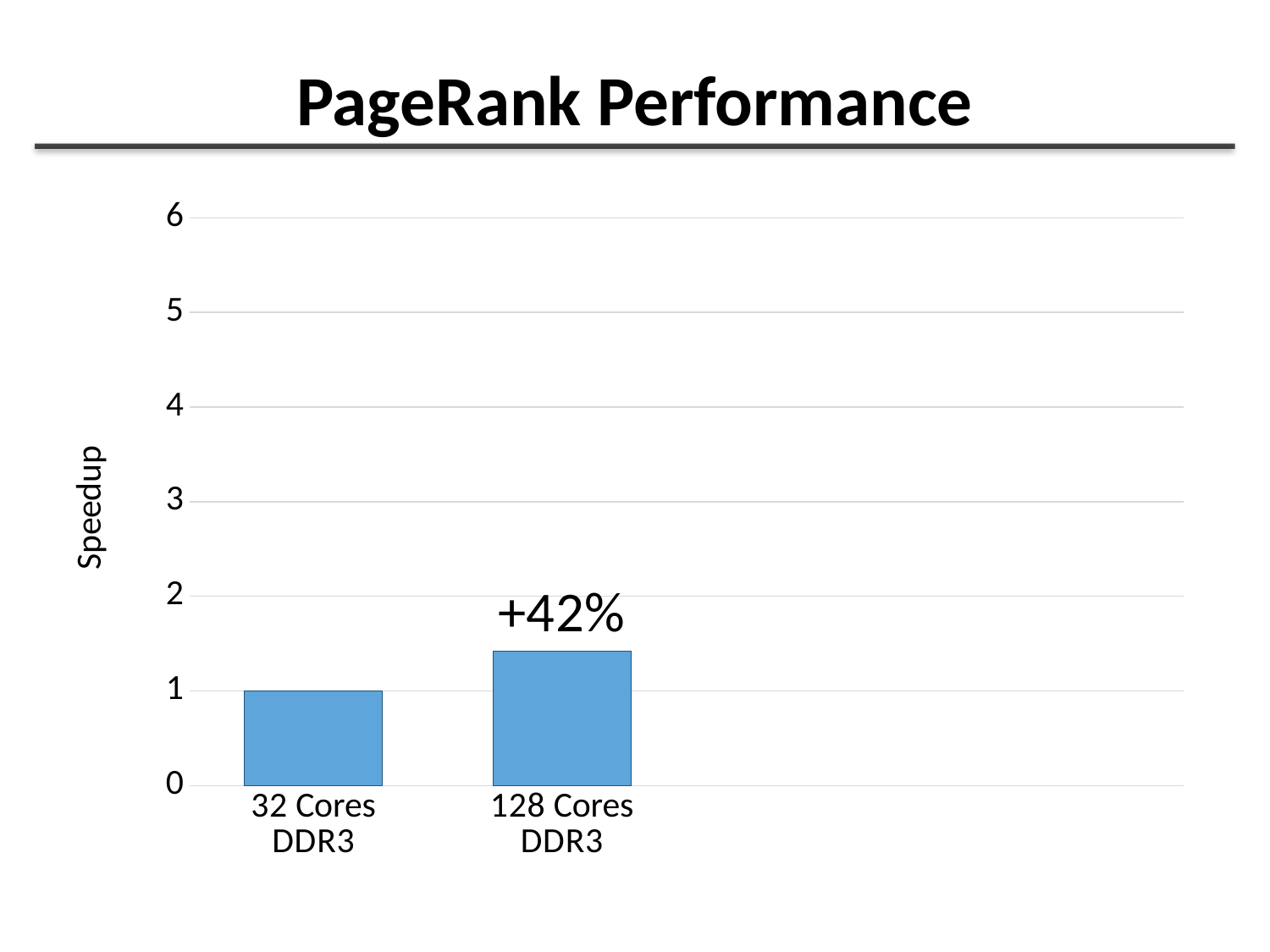
What is the highest value shown on the y axis? 6 What is the title of the chart? PageRank Performance Do the speedup values rise or fall from left to right along the x axis? rise What is the speedup value for 32 Cores DDR3? 1 How many bars are plotted in the chart? 2 What is the label on the y axis? Speedup Which category has the lowest speedup? 32 Cores DDR3 Is the speedup for 128 Cores DDR3 greater or less than 1? greater Is the speedup for 128 Cores DDR3 greater or less than 2? less Which category has the highest speedup? 128 Cores DDR3 What kind of chart is shown on the slide? bar chart Which is larger, the speedup for 32 Cores DDR3 or for 128 Cores DDR3? 128 Cores DDR3